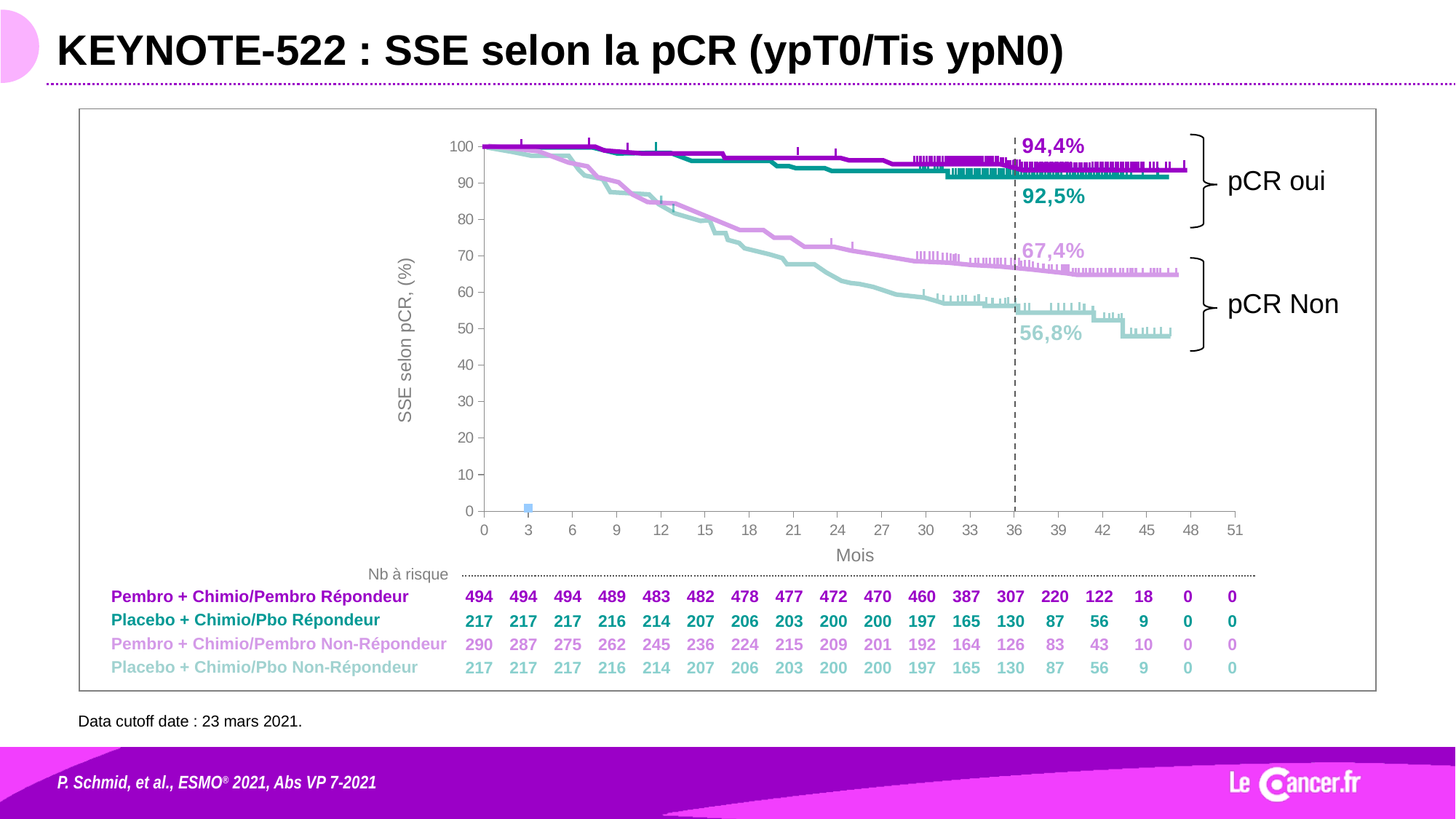
What is the 36-month SSE rate shown for the Pembro + Chimio/Pembro Non-Répondeur group? 67,4% Which group has the highest 36-month SSE rate? Pembro + Chimio/Pembro Répondeur What kind of chart is shown on the slide? Line chart (Kaplan-Meier curve) What is the difference between the 36-month SSE rates of the two pCR Non groups (67,4% and 56,8%)? 10,6 points How many groups (curves) are plotted on the chart? 4 Do the SSE curves rise or fall as the months increase? fall What is the 36-month SSE rate shown for the Pembro + Chimio/Pembro Répondeur group? 94,4% How many patients were at risk at 0 months in the Pembro + Chimio/Pembro Répondeur group? 494 What is the 36-month SSE rate shown for the Placebo + Chimio/Pbo Non-Répondeur group? 56,8% How many patients were at risk at 36 months in the Pembro + Chimio/Pembro Non-Répondeur group? 126 What is the difference between the 36-month SSE rates of the two pCR oui groups (94,4% and 92,5%)? 1,9 points Which group has the lowest 36-month SSE rate? Placebo + Chimio/Pbo Non-Répondeur